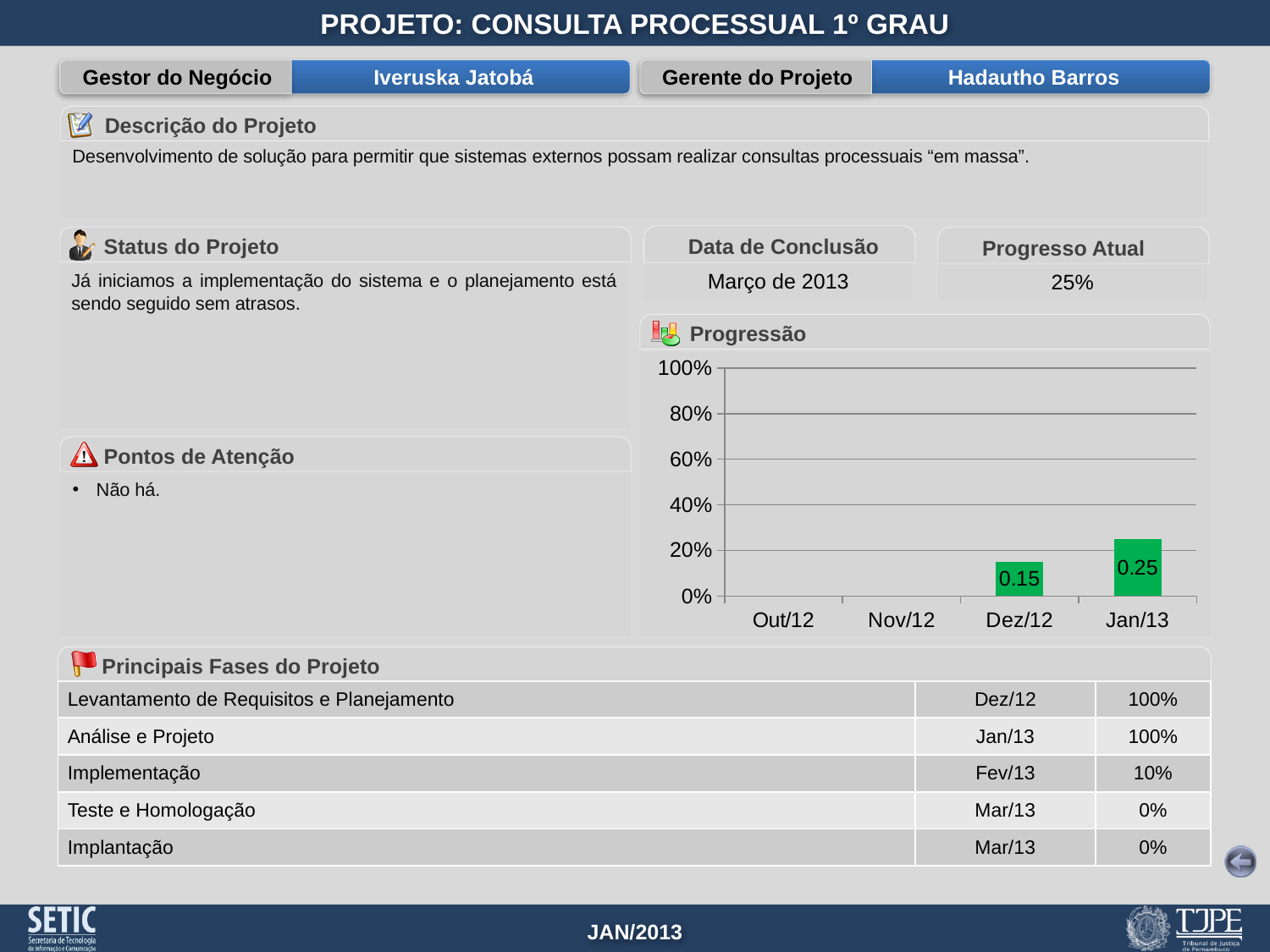
In the Progressão chart, which is larger: the value for Dez/12 or the value for Jan/13? Jan/13 Which month has the highest bar in the Progressão chart? Jan/13 What is the value shown for Dez/12 in the Progressão chart? 0.15 Is the bar for Dez/12 in the Progressão chart greater or less than 20%? less How many months are shown on the x axis of the Progressão chart? 4 Is the bar for Jan/13 in the Progressão chart greater or less than 20%? greater What is the value shown for Jan/13 in the Progressão chart? 0.25 Do the values in the Progressão chart rise or fall from Dez/12 to Jan/13? rise What is the difference between the Jan/13 and Dez/12 values in the Progressão chart? 0.1 What colour are the bars in the Progressão chart? green What is the title of the chart on the slide? Progressão What kind of chart is the Progressão chart? bar chart